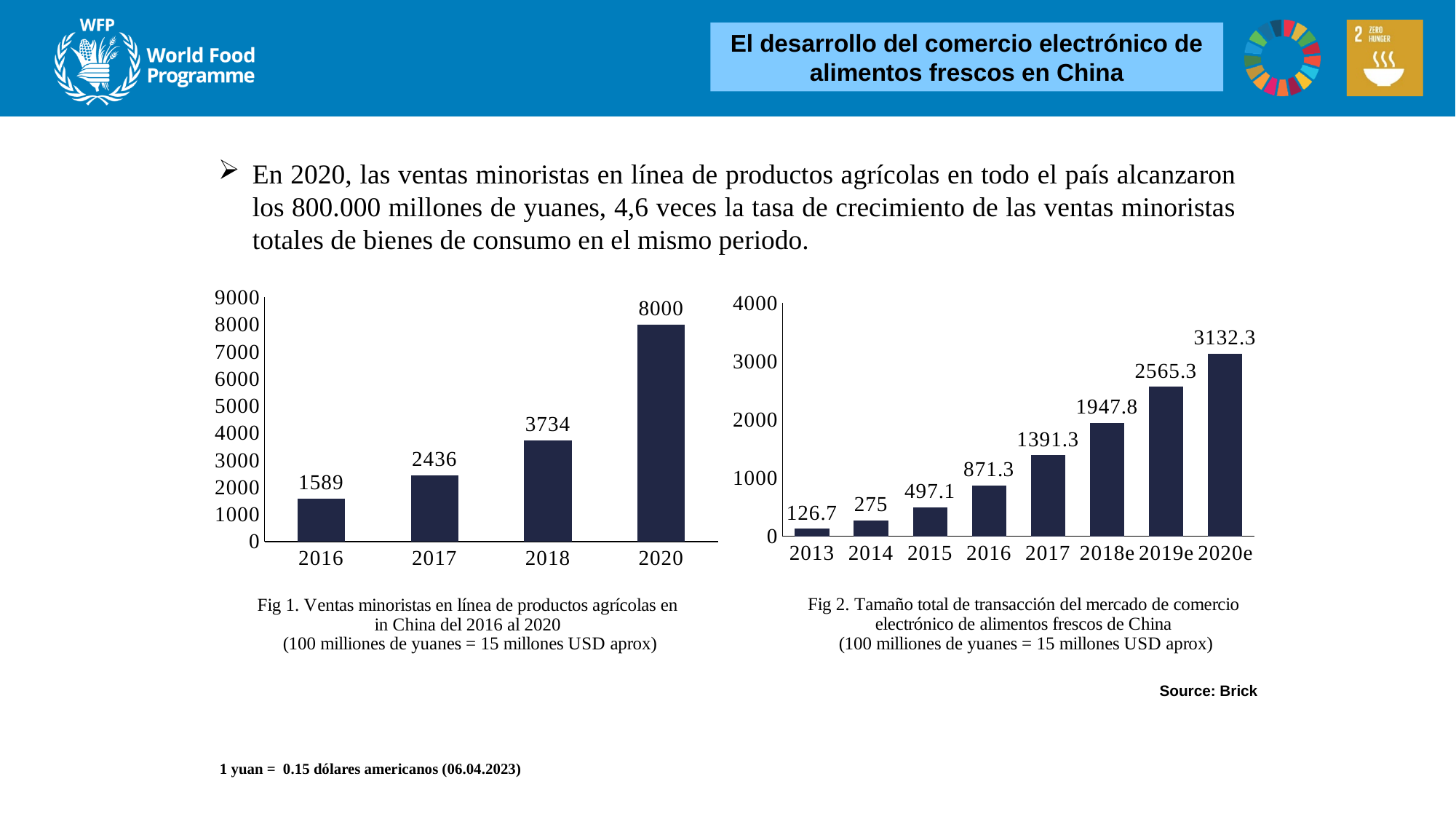
What type of chart is Fig 2 (right chart)? bar chart In Fig 1 (left chart), do the values rise or fall from 2016 to 2020? rise In Fig 2 (right chart), what is the value for 2014? 275 In Fig 2 (right chart), which is larger, the value for 2015 or the value for 2016? 2016 In Fig 1 (left chart), what is the value for 2018? 3734 In Fig 2 (right chart), what is the value for 2017? 1391.3 In Fig 2 (right chart), what is the difference between the values for 2020e and 2019e? 567 In Fig 2 (right chart), which year has the lowest value? 2013 In Fig 2 (right chart), how many years are shown on the x axis? 8 In Fig 1 (left chart), which year has the highest value? 2020 In Fig 1 (left chart), what is the difference between the values for 2020 and 2016? 6411 In Fig 1 (left chart), how many bars are plotted? 4